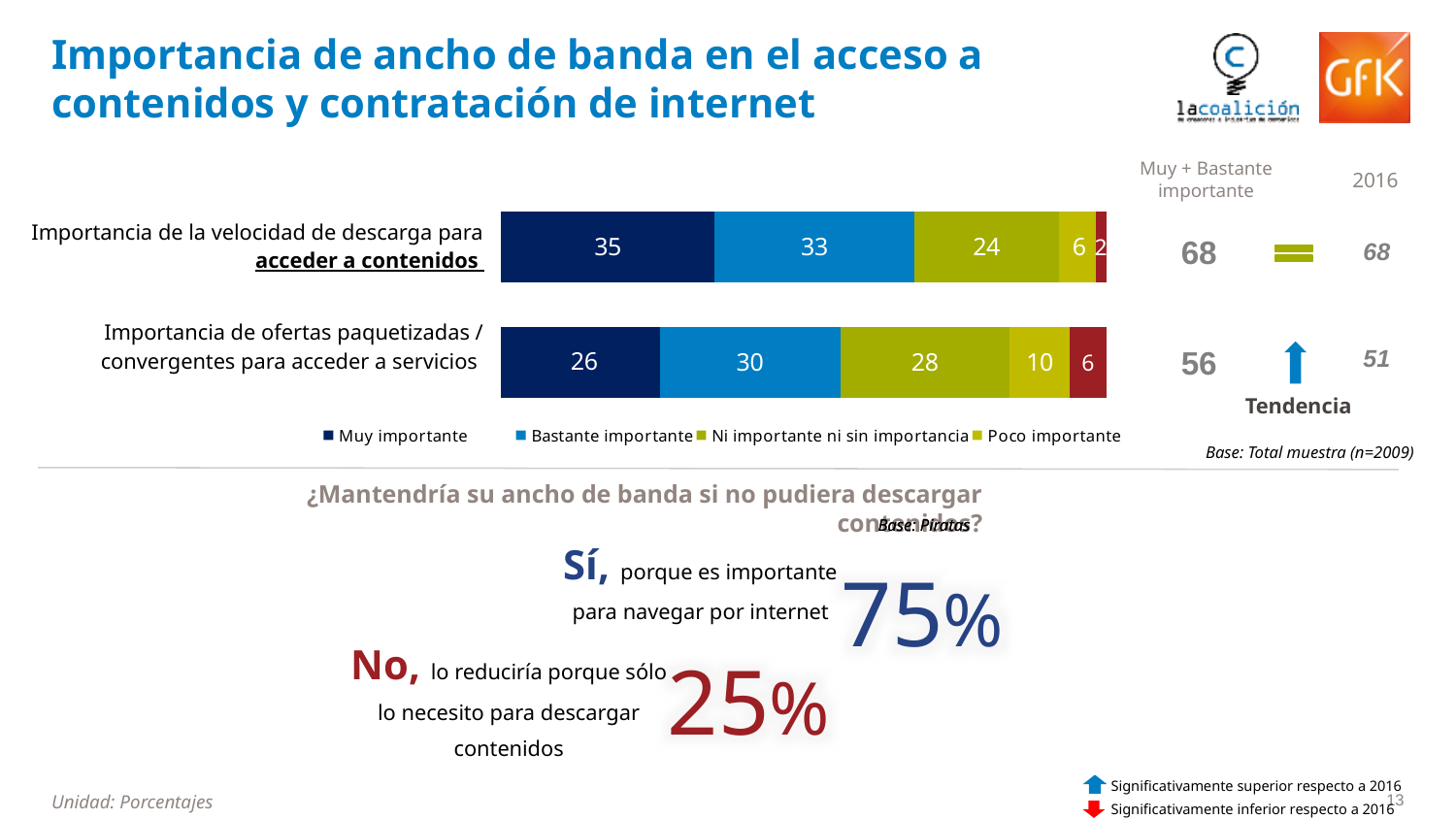
How many categories does the stacked bar chart show? 2 What is the 'Muy + Bastante importante' value shown next to the bar for 'Importancia de la velocidad de descarga para acceder a contenidos'? 68 In the stacked bar chart, what is the value for 'Poco importante' for 'Importancia de ofertas paquetizadas / convergentes para acceder a servicios'? 10 What colour represents 'Muy importante' in the stacked bar chart legend? Dark blue What kind of chart is shown at the top of the slide? Stacked bar chart In the stacked bar chart, what is the total of the stacked bar for 'Importancia de ofertas paquetizadas / convergentes para acceder a servicios'? 100 In the stacked bar chart, what is the value for 'Ni importante ni sin importancia' for 'Importancia de la velocidad de descarga para acceder a contenidos'? 24 In the stacked bar chart, what is the value for 'Muy importante' for 'Importancia de la velocidad de descarga para acceder a contenidos'? 35 In the stacked bar chart, what is the value for 'Bastante importante' for 'Importancia de ofertas paquetizadas / convergentes para acceder a servicios'? 30 In the stacked bar chart, which category has the larger 'Bastante importante' value? Importancia de la velocidad de descarga para acceder a contenidos Which category has the highest 'Muy importante' value in the stacked bar chart? Importancia de la velocidad de descarga para acceder a contenidos In the stacked bar chart, what is the difference between the 'Muy importante' values of the two categories? 9